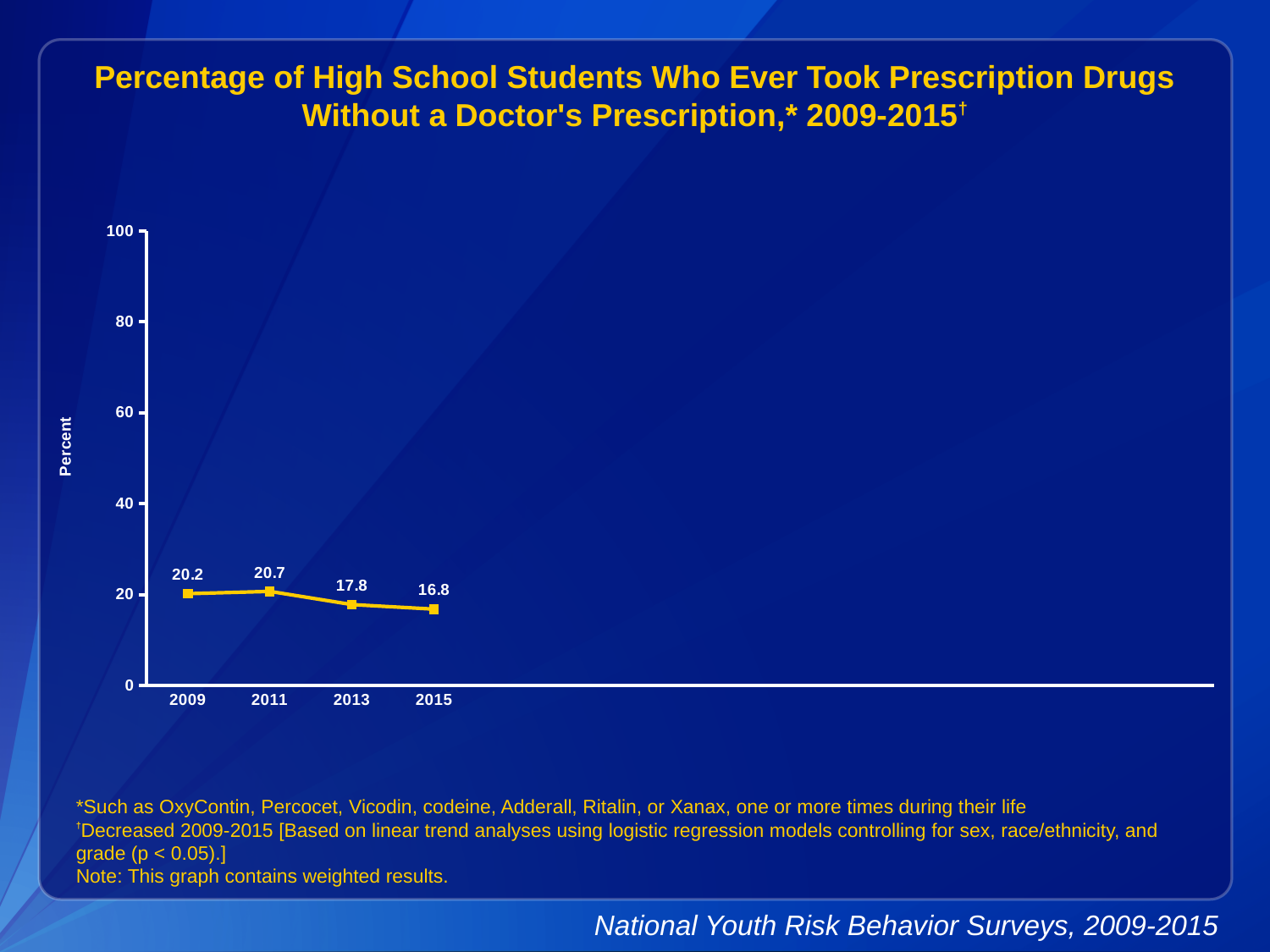
Is the value for 2015 greater or less than 20? less What kind of chart is shown on the slide? line chart What is the label on the y axis? Percent What is the difference between the 2009 value and the 2015 value? 3.4 Which year has the highest value on the chart? 2011 What is the value plotted for 2015? 16.8 Which year has the lowest value on the chart? 2015 What is the value plotted for 2013? 17.8 Which year has the larger value, 2013 or 2015? 2013 What percentage of high school students had ever taken prescription drugs without a doctor's prescription in 2009? 20.2 What is the value plotted for 2011? 20.7 How many years are plotted on the chart? 4